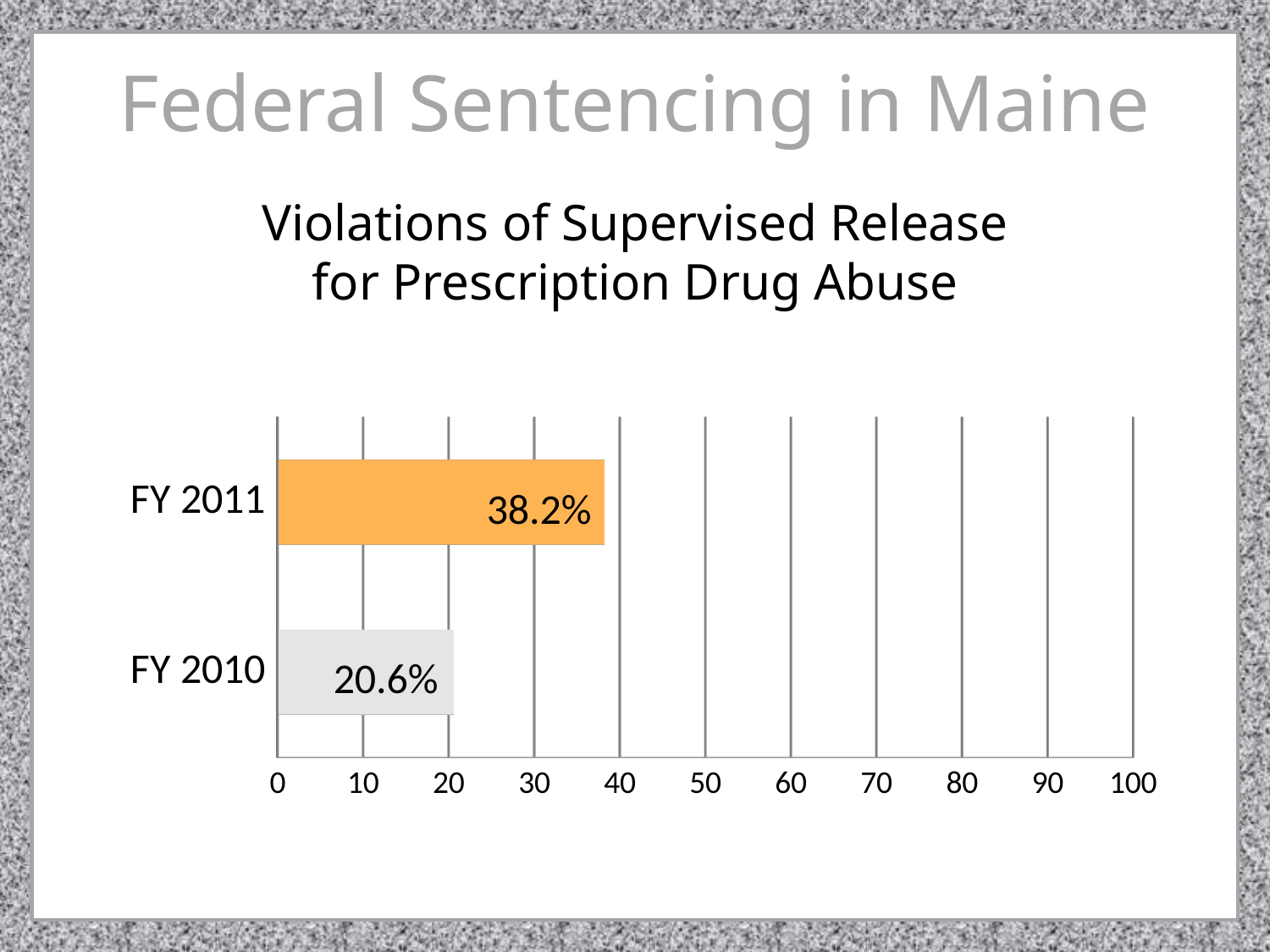
What is the value for FY 2011? 38.2% What kind of chart is shown on the slide? Bar chart How many categories are shown in the chart? 2 Which is larger, the value for FY 2010 or FY 2011? FY 2011 Which fiscal year has the highest value? FY 2011 Is the value for FY 2011 greater or less than 30? greater What is the value for FY 2010? 20.6% Is the value for FY 2010 greater or less than 30? less What is the title of the chart? Violations of Supervised Release for Prescription Drug Abuse Which fiscal year has the lowest value? FY 2010 Did the value rise or fall from FY 2010 to FY 2011? Rise What is the difference between the FY 2011 and FY 2010 values? 17.6%